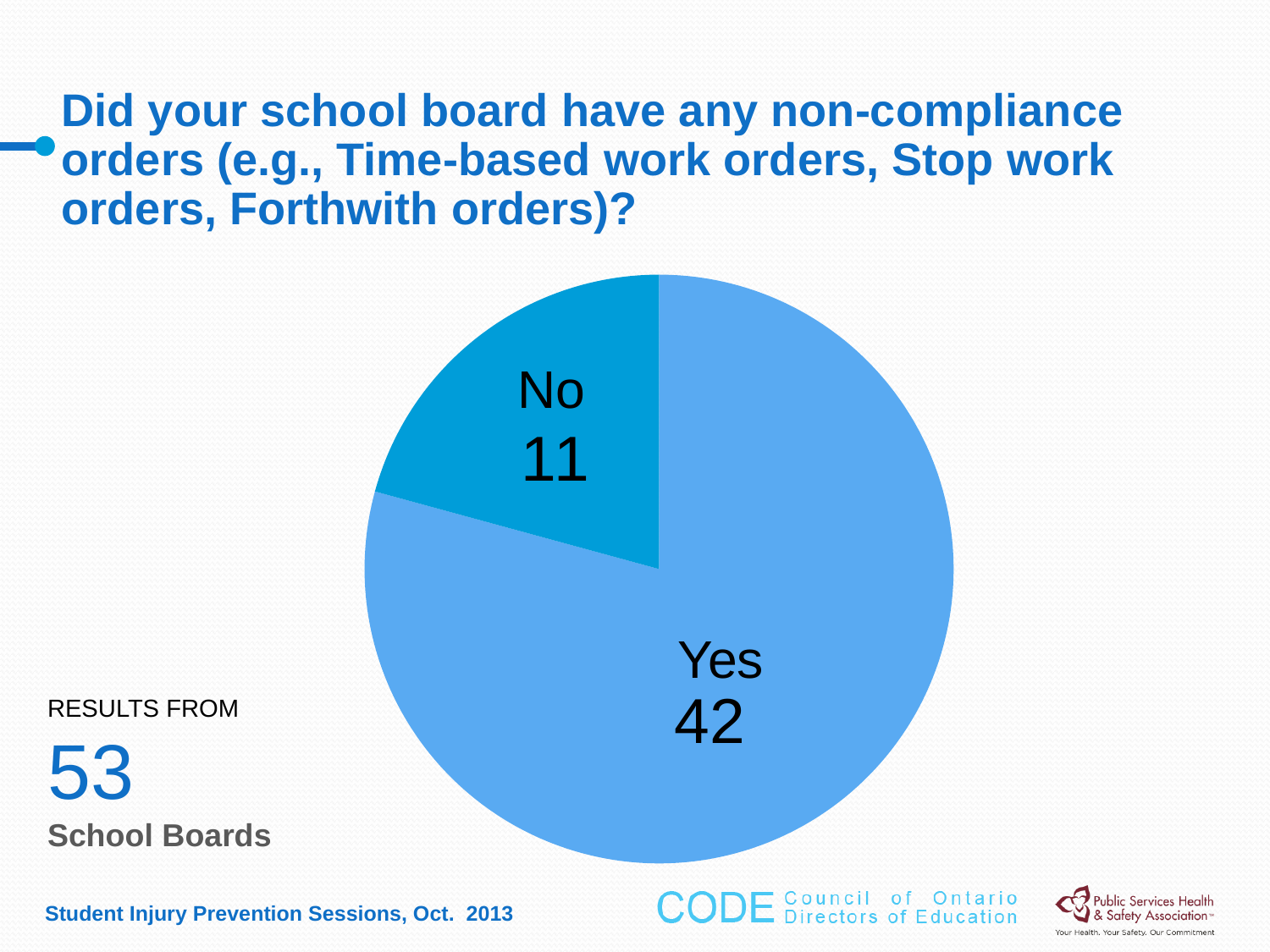
Which response category has the smallest slice in the pie chart? No Which response has the larger slice of the pie, Yes or No? Yes How many school boards are the results from, according to the text on the slide? 53 How many school boards answered "Yes" to having non-compliance orders? 42 How many school boards answered "No" to having non-compliance orders? 11 What is the total number of responses shown in the pie chart? 53 Which response category has the largest slice in the pie chart? Yes How many slices does the pie chart have? 2 What is the difference between the number of Yes responses and No responses? 31 What type of chart is shown on the slide? pie chart Which slice of the pie is the darker blue colour? No